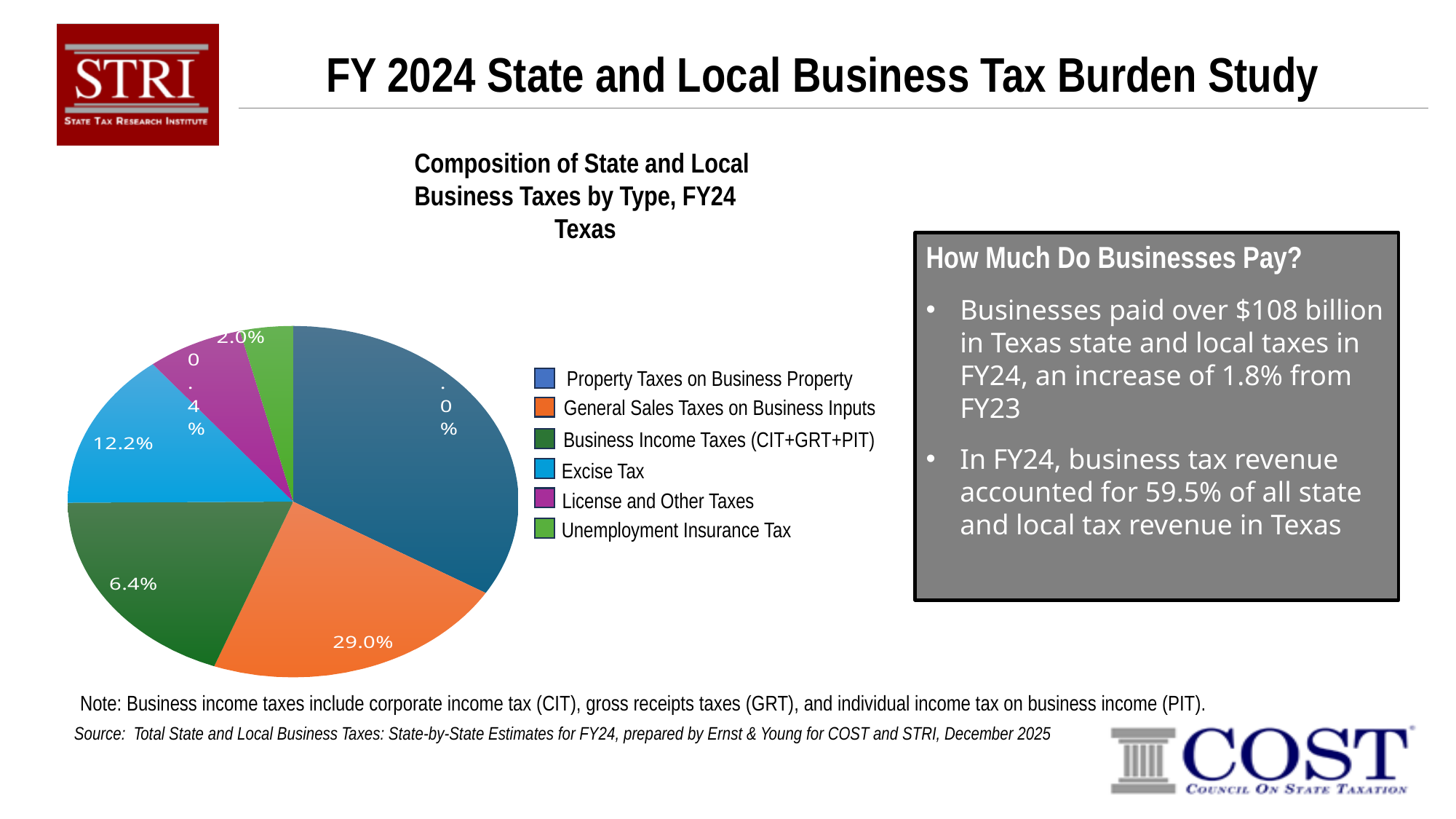
How many percentage points larger is the General Sales Taxes on Business Inputs slice than the Excise Tax slice? 16.8 percentage points What is the title of the pie chart? Composition of State and Local Business Taxes by Type, FY24 Texas What share of Texas state and local business taxes in FY24 comes from General Sales Taxes on Business Inputs? 29.0% What percentage of the pie is Unemployment Insurance Tax? 2.0% What share of the pie is Excise Tax? 12.2% What kind of chart is shown on the slide? Pie chart What percentage is shown for Business Income Taxes (CIT+GRT+PIT)? 6.4% Which tax type makes up the smallest slice of the pie chart? Unemployment Insurance Tax How many tax categories does the legend of the pie chart list? 6 Which tax type makes up the largest slice of the pie chart? Property Taxes on Business Property Which colour represents General Sales Taxes on Business Inputs in the pie chart? Orange